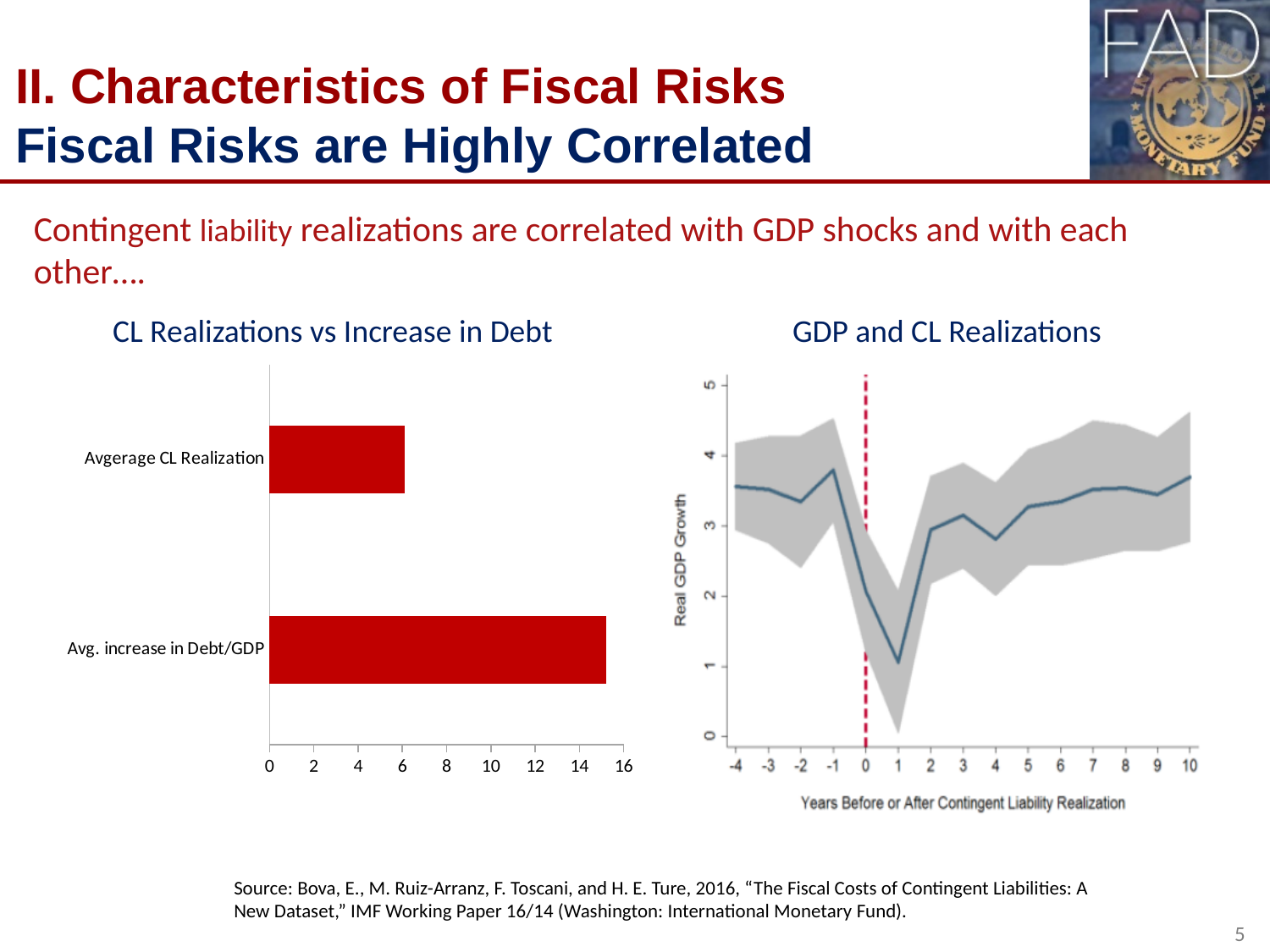
In the chart titled "CL Realizations vs Increase in Debt", what is the maximum value shown on the horizontal axis? 16 In the chart titled "GDP and CL Realizations", is the value of Real GDP Growth at year 1 greater or less than 2? less In the chart titled "CL Realizations vs Increase in Debt", which category has the larger value? Avg. increase in Debt/GDP In the chart titled "GDP and CL Realizations", what kind of chart is shown? line chart In the chart titled "GDP and CL Realizations", what is the label of the vertical axis? Real GDP Growth In the chart titled "CL Realizations vs Increase in Debt", what kind of chart is shown? bar chart In the chart titled "GDP and CL Realizations", is Real GDP Growth at year -1 greater or less than at year 1? greater In the chart titled "CL Realizations vs Increase in Debt", how many categories are plotted? 2 In the chart titled "CL Realizations vs Increase in Debt", is the value for Avgerage CL Realization greater or less than 8? less In the chart titled "CL Realizations vs Increase in Debt", is the value for Avg. increase in Debt/GDP greater or less than 14? greater In the chart titled "CL Realizations vs Increase in Debt", which category has the smaller value? Avgerage CL Realization In the chart titled "GDP and CL Realizations", does Real GDP Growth rise or fall between year 0 and year 1? fall